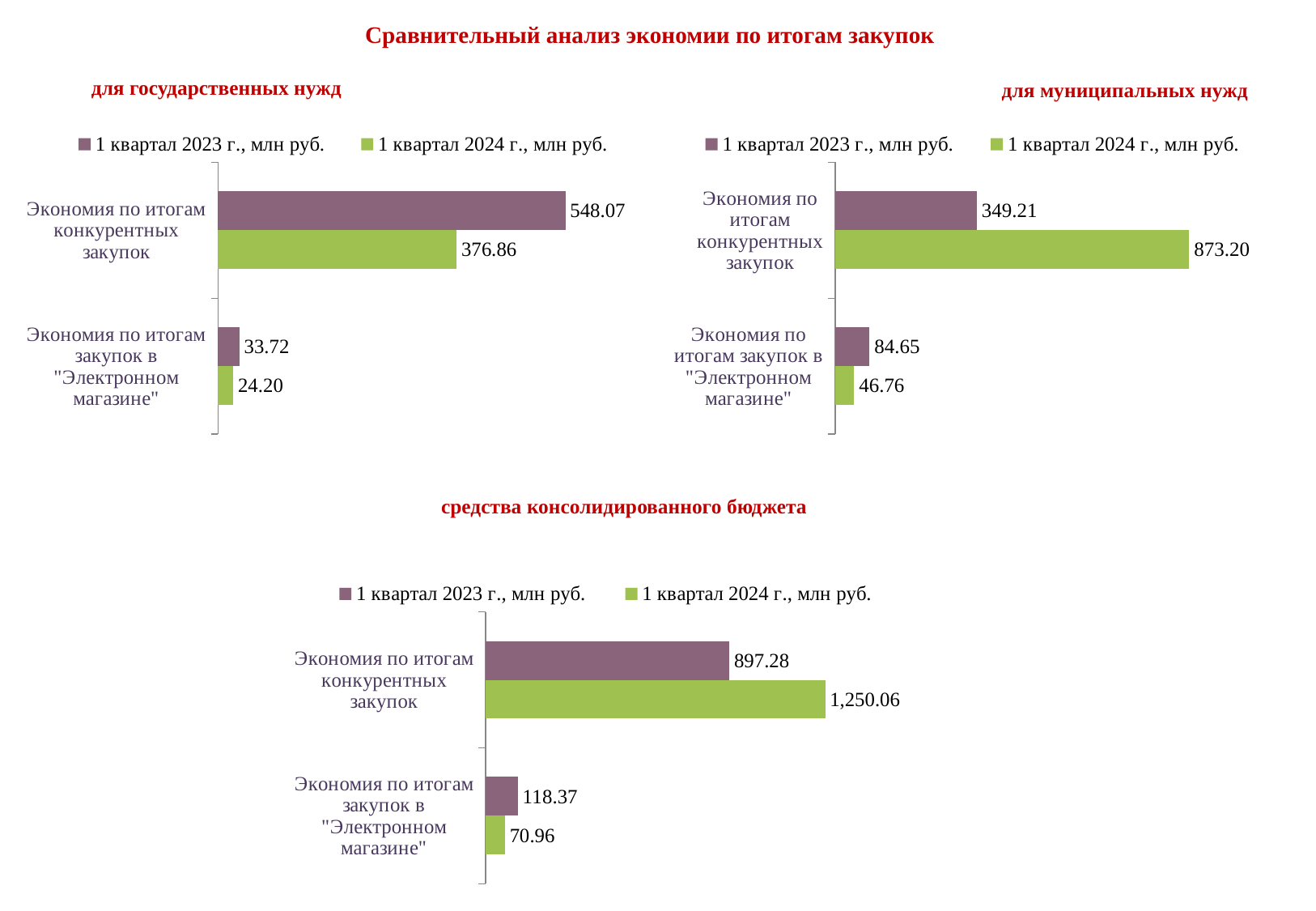
How many series does the legend of the chart 'средства консолидированного бюджета' list? 2 In the chart 'для муниципальных нужд', which bar has the lowest value? Экономия по итогам закупок в "Электронном магазине", 1 квартал 2024 г. In the chart 'для государственных нужд', what is the difference between the 1 квартал 2023 г. and 1 квартал 2024 г. values for 'Экономия по итогам закупок в "Электронном магазине"'? 9.52 In the chart 'для муниципальных нужд', what is the value for 'Экономия по итогам конкурентных закупок' in 1 квартал 2024 г.? 873.20 How many categories are shown in the chart 'для государственных нужд'? 2 In the chart 'средства консолидированного бюджета', what is the difference between the 1 квартал 2024 г. and 1 квартал 2023 г. values for 'Экономия по итогам конкурентных закупок'? 352.78 In the chart 'средства консолидированного бюджета', what is the value for 'Экономия по итогам закупок в "Электронном магазине"' in 1 квартал 2024 г.? 70.96 In the chart 'для государственных нужд', which bar has the highest value? Экономия по итогам конкурентных закупок, 1 квартал 2023 г. What kind of chart is 'для муниципальных нужд'? Bar chart In the chart 'средства консолидированного бюджета', which is larger for 'Экономия по итогам закупок в "Электронном магазине"': 1 квартал 2023 г. or 1 квартал 2024 г.? 1 квартал 2023 г. In the chart 'для муниципальных нужд', which is larger for 'Экономия по итогам конкурентных закупок': 1 квартал 2023 г. or 1 квартал 2024 г.? 1 квартал 2024 г. In the chart 'для государственных нужд', what is the value for 'Экономия по итогам конкурентных закупок' in 1 квартал 2023 г.? 548.07